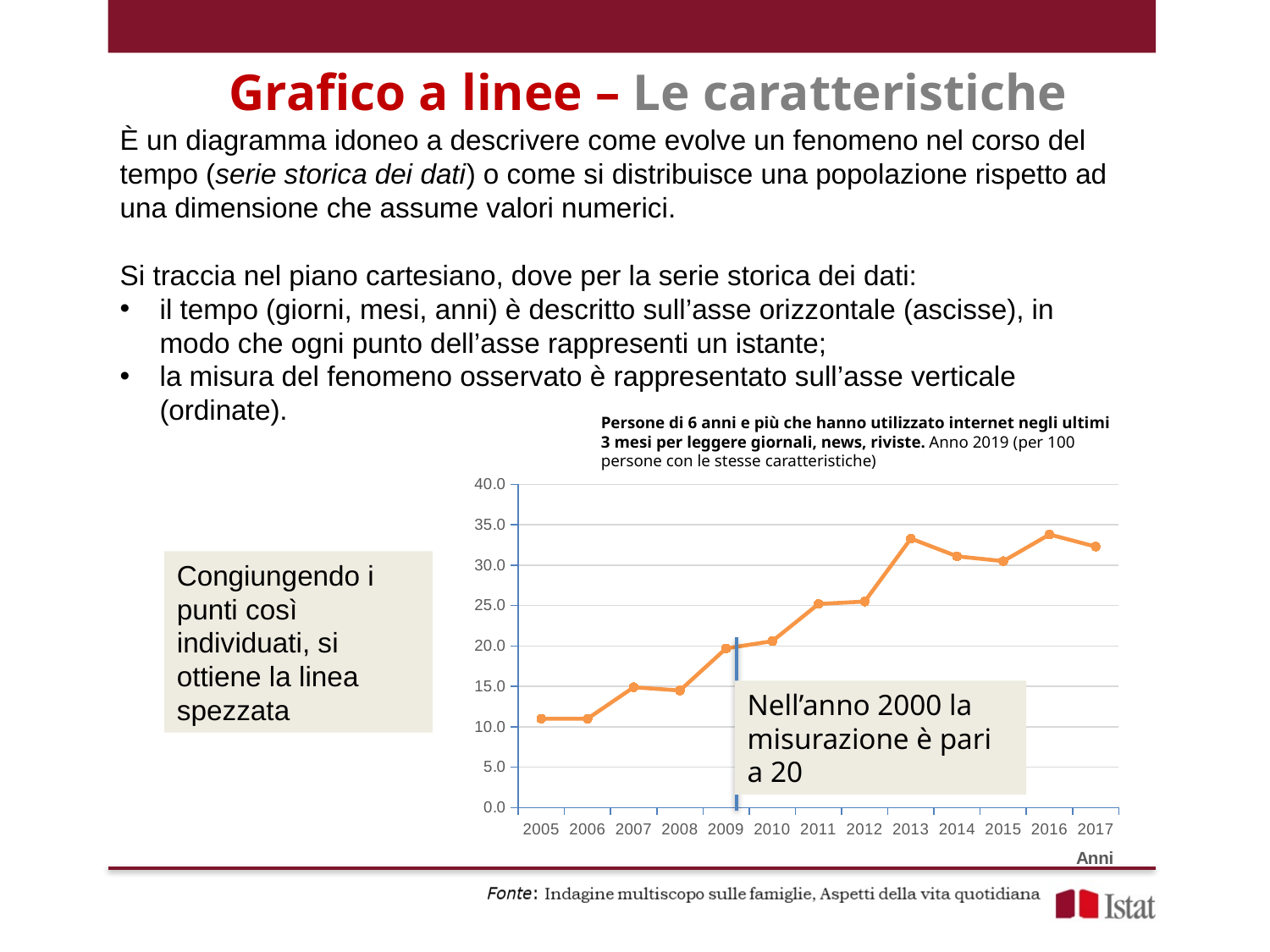
What kind of chart is shown on the slide? line chart Which year has the larger value, 2009 or 2013? 2013 Is the value for 2011 greater or less than 20.0? greater Is the value for 2005 greater or less than 15.0? less What is the first year shown on the x axis of the chart? 2005 What is the label of the horizontal axis of the chart? Anni Overall, do the values in the chart rise or fall from 2005 to 2017? rise Is the value for 2013 greater or less than 30.0? greater Which year has the larger value, 2006 or 2012? 2012 How many years (data points) are plotted on the x axis of the chart? 13